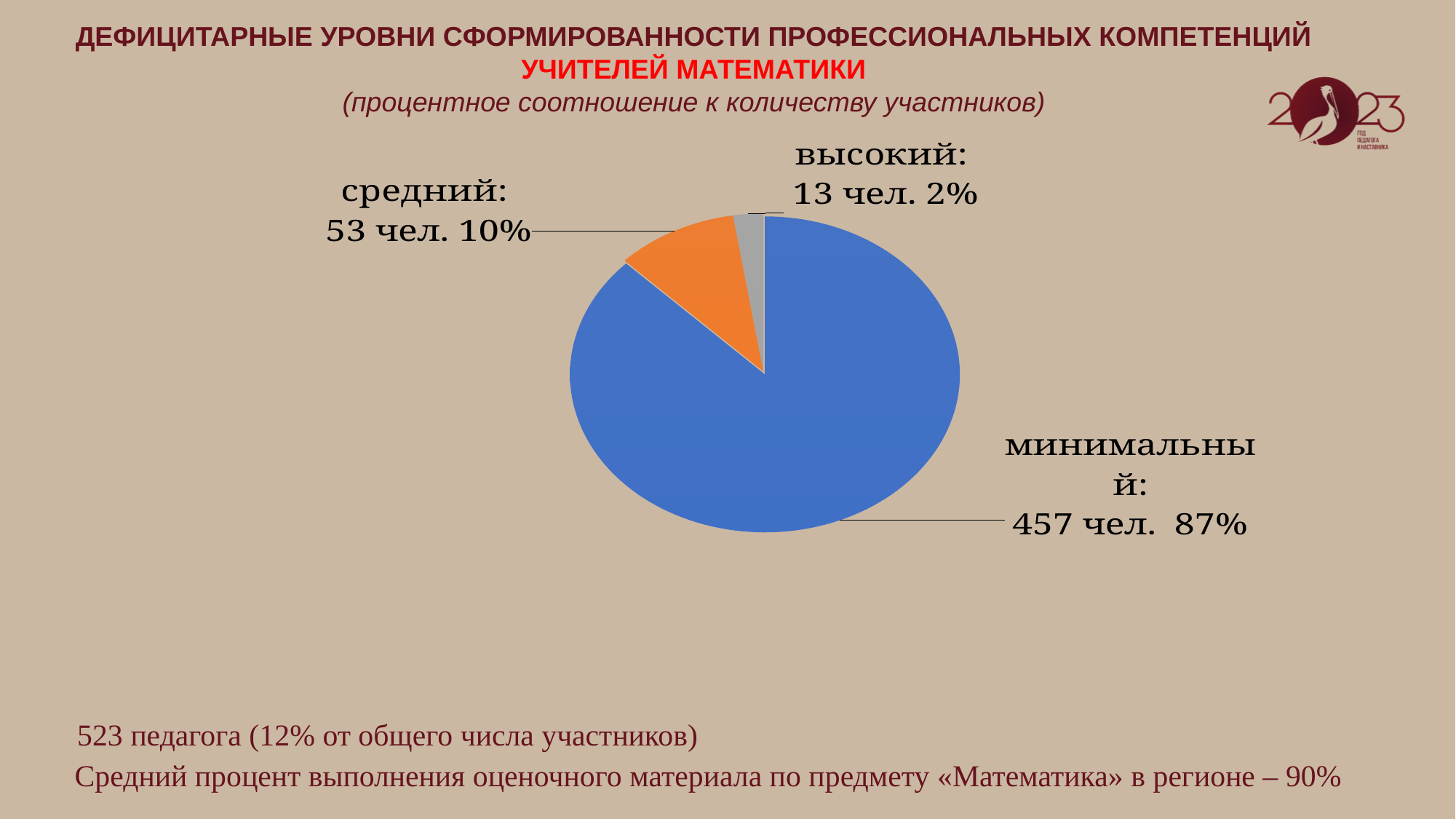
Какая категория имеет наибольшую долю на диаграмме? минимальный Какой процент приходится на категорию «высокий»? 2% Какая категория имеет наименьшую долю на диаграмме? высокий Какая доля диаграммы приходится на категорию «минимальный»? 87% Сколько категорий (секторов) показано на круговой диаграмме? 3 На сколько человек больше в категории «средний», чем в категории «высокий»? 40 Сколько человек относится к категории «высокий»? 13 чел. Каким цветом показан сектор «средний»? оранжевым Сколько человек относится к категории «минимальный»? 457 чел. Какой тип диаграммы показан на слайде? круговая диаграмма Какая категория больше: «средний» или «высокий»? средний Какой процент приходится на категорию «средний»? 10%